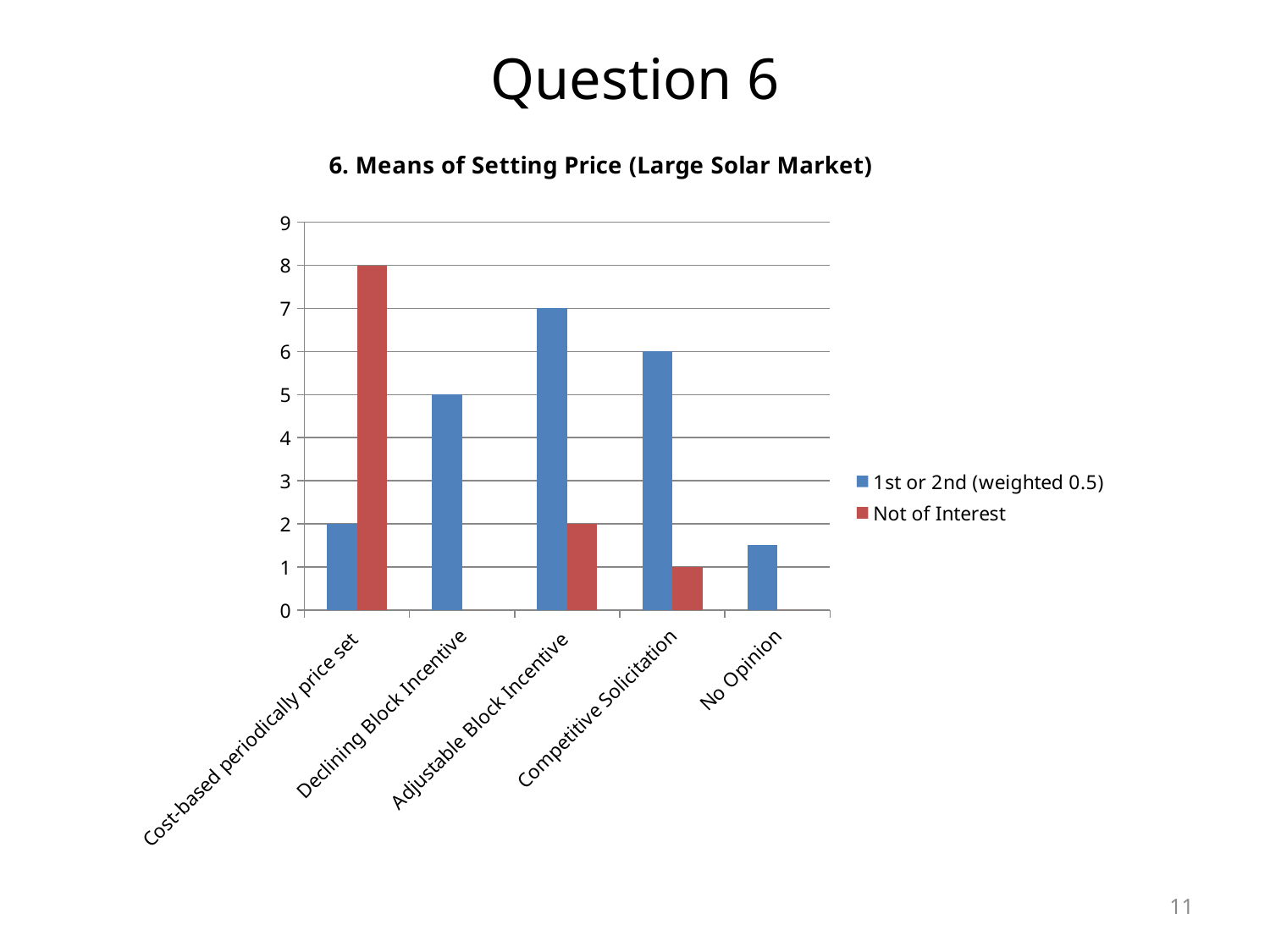
How many categories are shown on the x axis? 5 What is the title of the chart? 6. Means of Setting Price (Large Solar Market) Which category has the lowest '1st or 2nd (weighted 0.5)' value? No Opinion Which category has the highest '1st or 2nd (weighted 0.5)' value? Adjustable Block Incentive What is the 'Not of Interest' value for Cost-based periodically price set? 8 What kind of chart is shown on the slide? Bar chart How many series does the legend list? 2 Is the '1st or 2nd (weighted 0.5)' value for No Opinion greater or less than 2? less For Cost-based periodically price set, what is the difference between the 'Not of Interest' value and the '1st or 2nd (weighted 0.5)' value? 6 For the '1st or 2nd (weighted 0.5)' series, which is larger: Declining Block Incentive or Competitive Solicitation? Competitive Solicitation What is the '1st or 2nd (weighted 0.5)' value for Adjustable Block Incentive? 7 Which category has the highest 'Not of Interest' value? Cost-based periodically price set